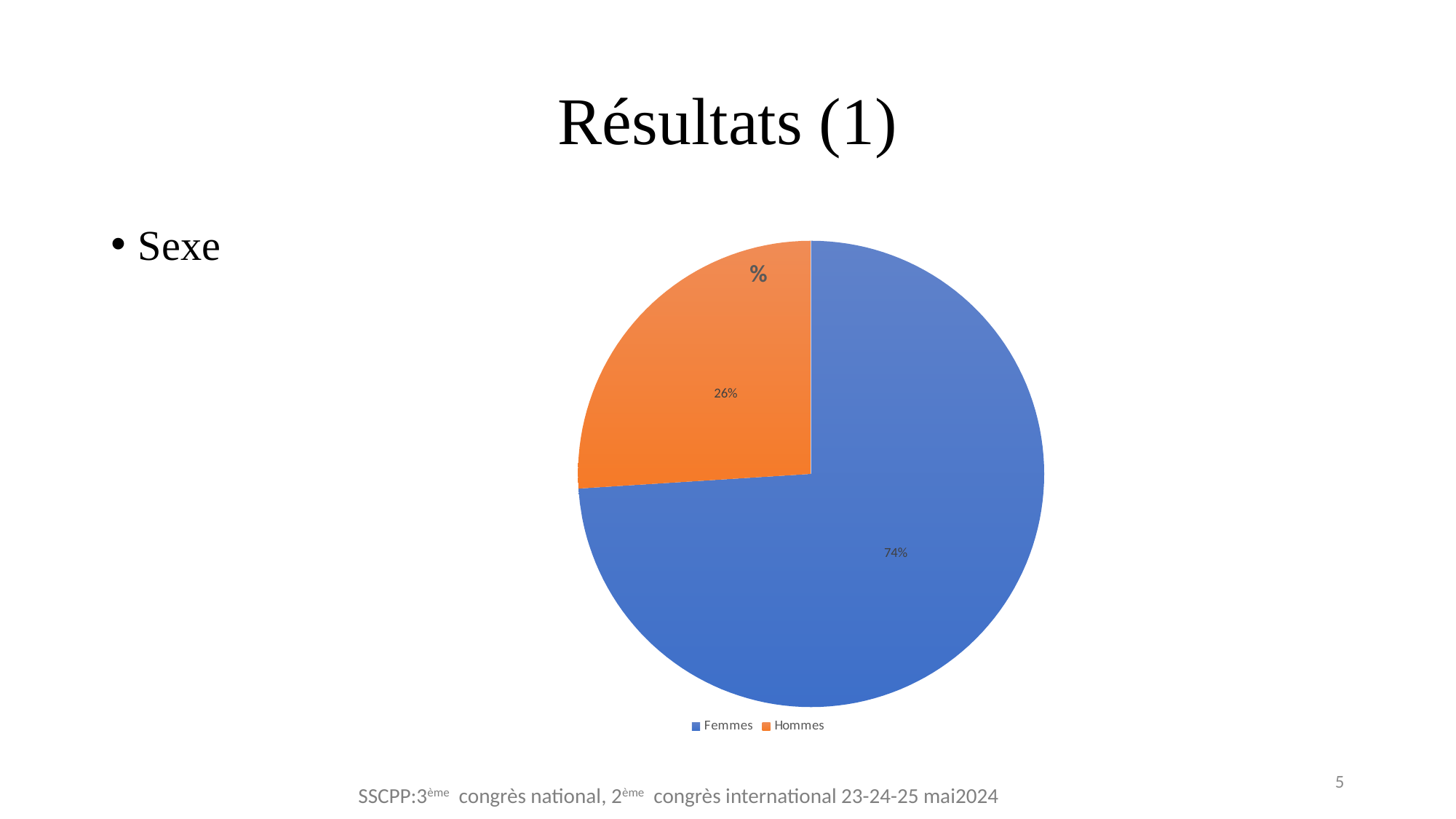
What share of the pie is Femmes? 74% Which category has the largest slice of the pie? Femmes What is the title shown above the chart? % What is the difference in percentage points between Femmes and Hommes? 48 What kind of chart is shown on the slide? pie chart How many categories does the pie chart show? 2 Which is larger, the Femmes slice or the Hommes slice? Femmes What colour is the Hommes slice? orange What share of the pie is Hommes? 26% Which category has the smallest slice of the pie? Hommes